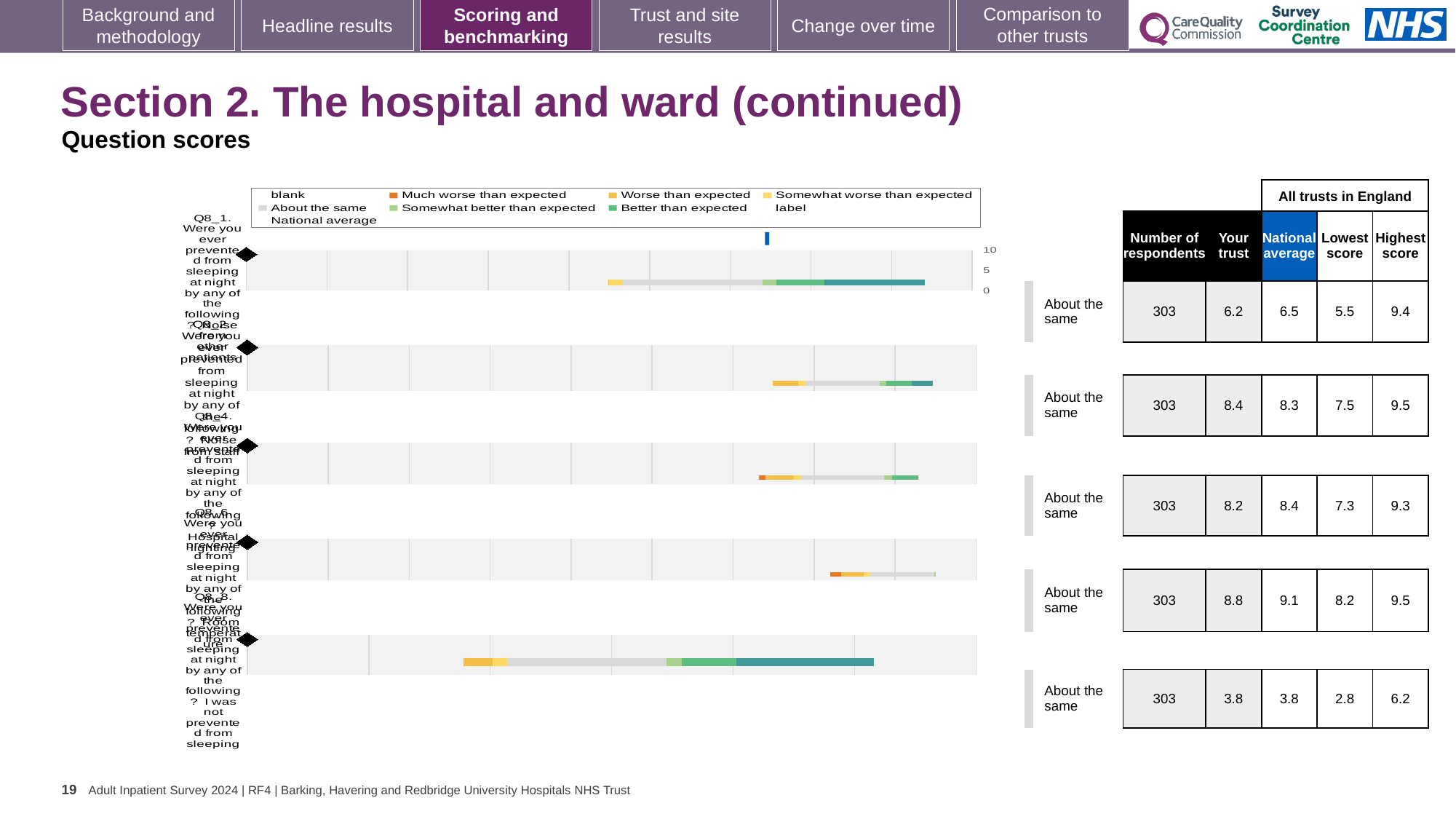
What kind of chart is shown on the slide? bar chart Which row has the lowest 'Your trust' score in the table? the last row (Q8_8), 3.8 How many question rows (bars) are plotted in the chart? 5 In the table, what is the national average for the first row (Q8_1)? 6.5 In the table, what is the 'Your trust' score for the first row (Q8_1)? 6.2 What colour does the legend use for 'Better than expected'? teal What colour does the legend use for 'Much worse than expected'? orange-red How many respondents are listed for each question in the table? 303 For the fourth row (Q8_6), what is the difference between the national average (9.1) and the 'Your trust' score (8.8)? 0.3 For the first row (Q8_1), which is larger: the 'Your trust' score or the national average? National average What benchmark label is shown next to each bar? About the same In the table, what is the highest score for the last row (Q8_8)? 6.2